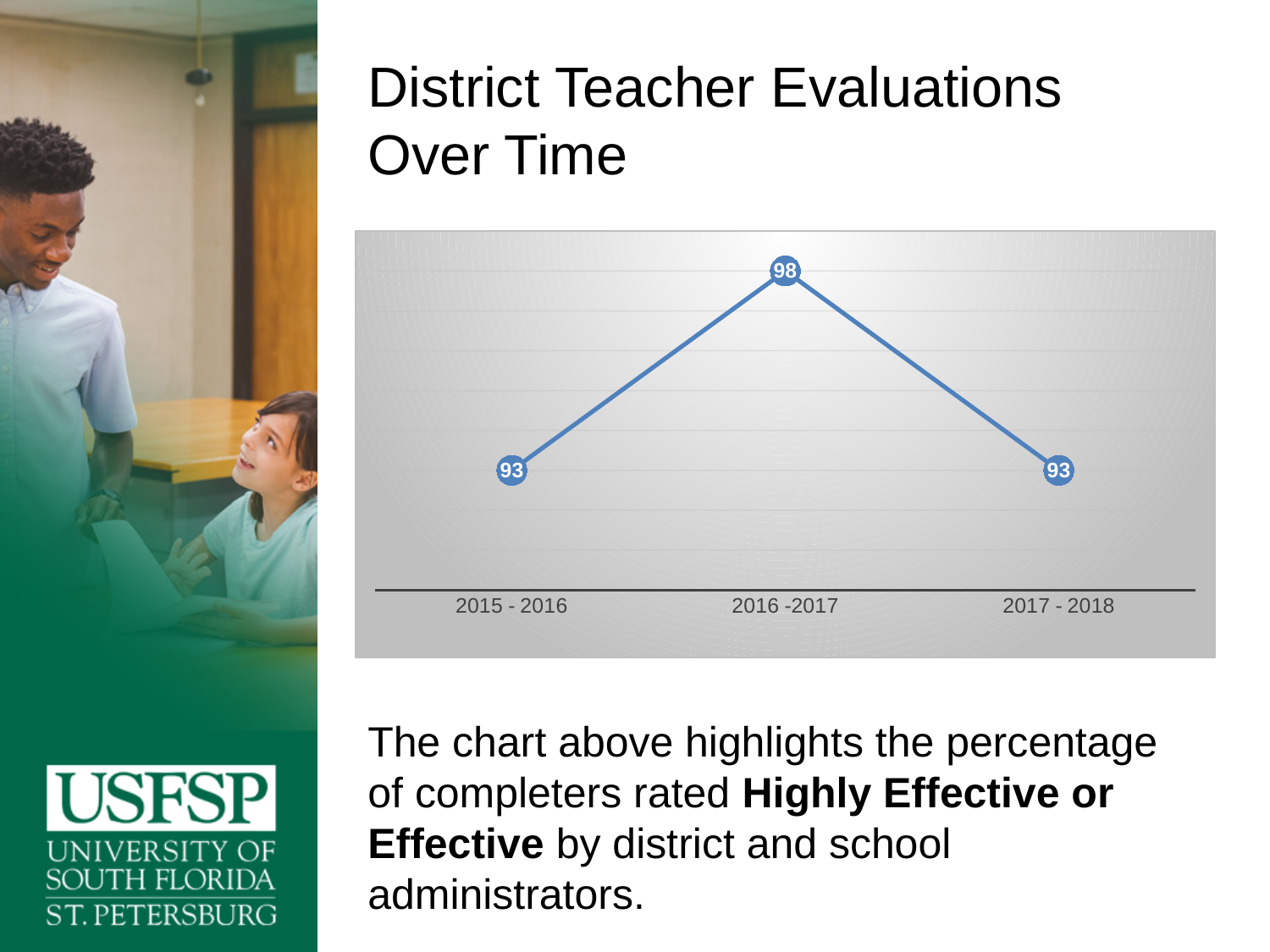
How many periods are plotted on the x axis? 3 What is the title of the slide containing the chart? District Teacher Evaluations Over Time What colour is the line in the chart? Blue What kind of chart is shown on the slide? Line chart What is the value for 2015 - 2016? 93 What is the value for 2016 -2017? 98 Does the value rise or fall from 2015 - 2016 to 2016 -2017? Rise What is the difference between the values for 2016 -2017 and 2015 - 2016? 5 Does the value rise or fall from 2016 -2017 to 2017 - 2018? Fall What is the value for 2017 - 2018? 93 Which is larger, the value for 2016 -2017 or the value for 2017 - 2018? 2016 -2017 Which period has the highest value? 2016 -2017